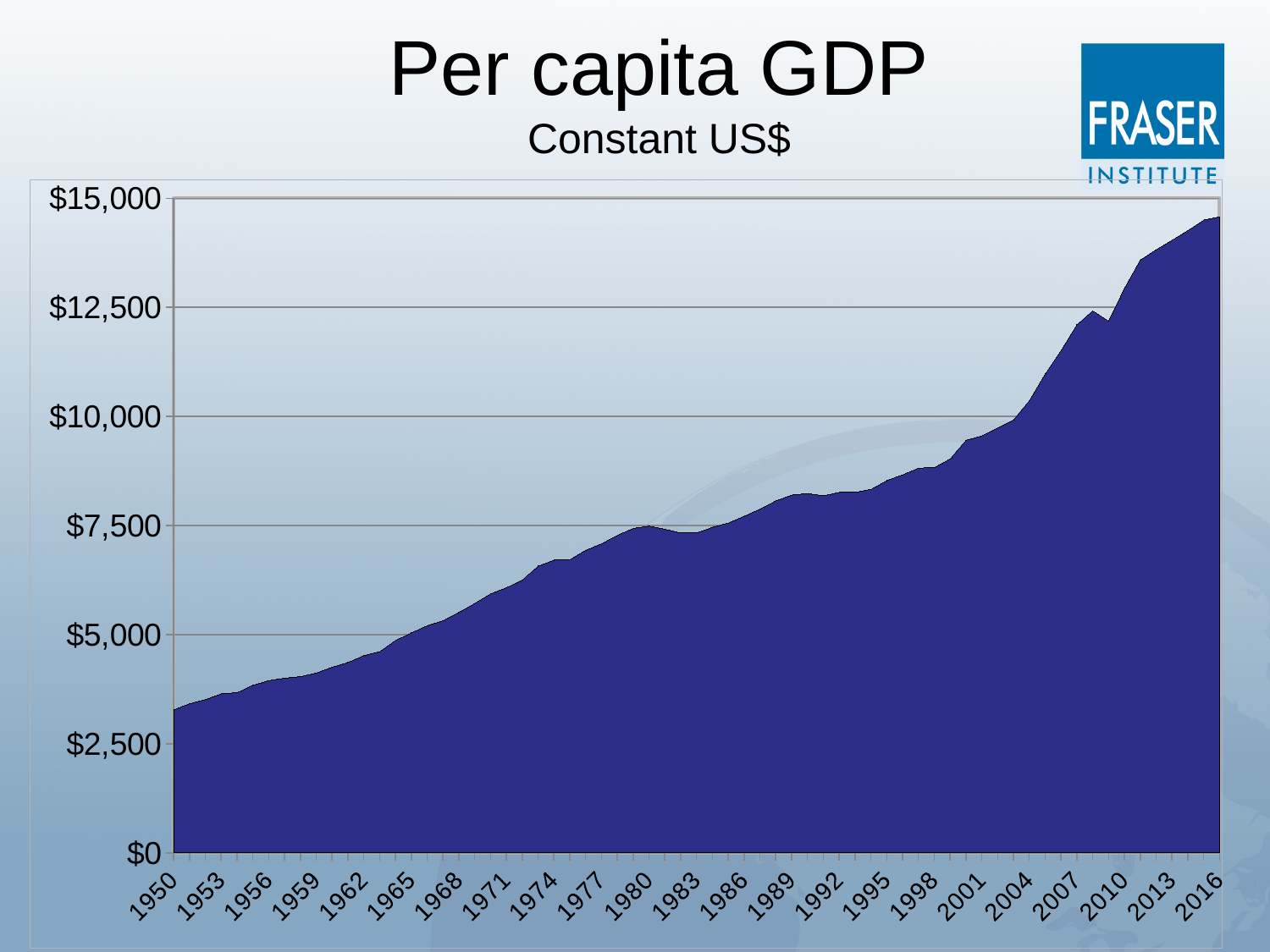
Which year has the lowest per capita GDP on the chart? 1950 Is the per capita GDP for 2001 greater or less than $10,000? less Is the per capita GDP for 1974 greater or less than $7,500? less Is the per capita GDP for 2016 greater or less than $12,500? greater What kind of chart is shown on the slide? area chart Does per capita GDP generally rise or fall from 1950 to 2016? rise In what units are the values on the chart expressed, according to the subtitle? Constant US$ What is the title of the chart? Per capita GDP Which year has the highest per capita GDP on the chart? 2016 Which year has the larger per capita GDP, 1998 or 2007? 2007